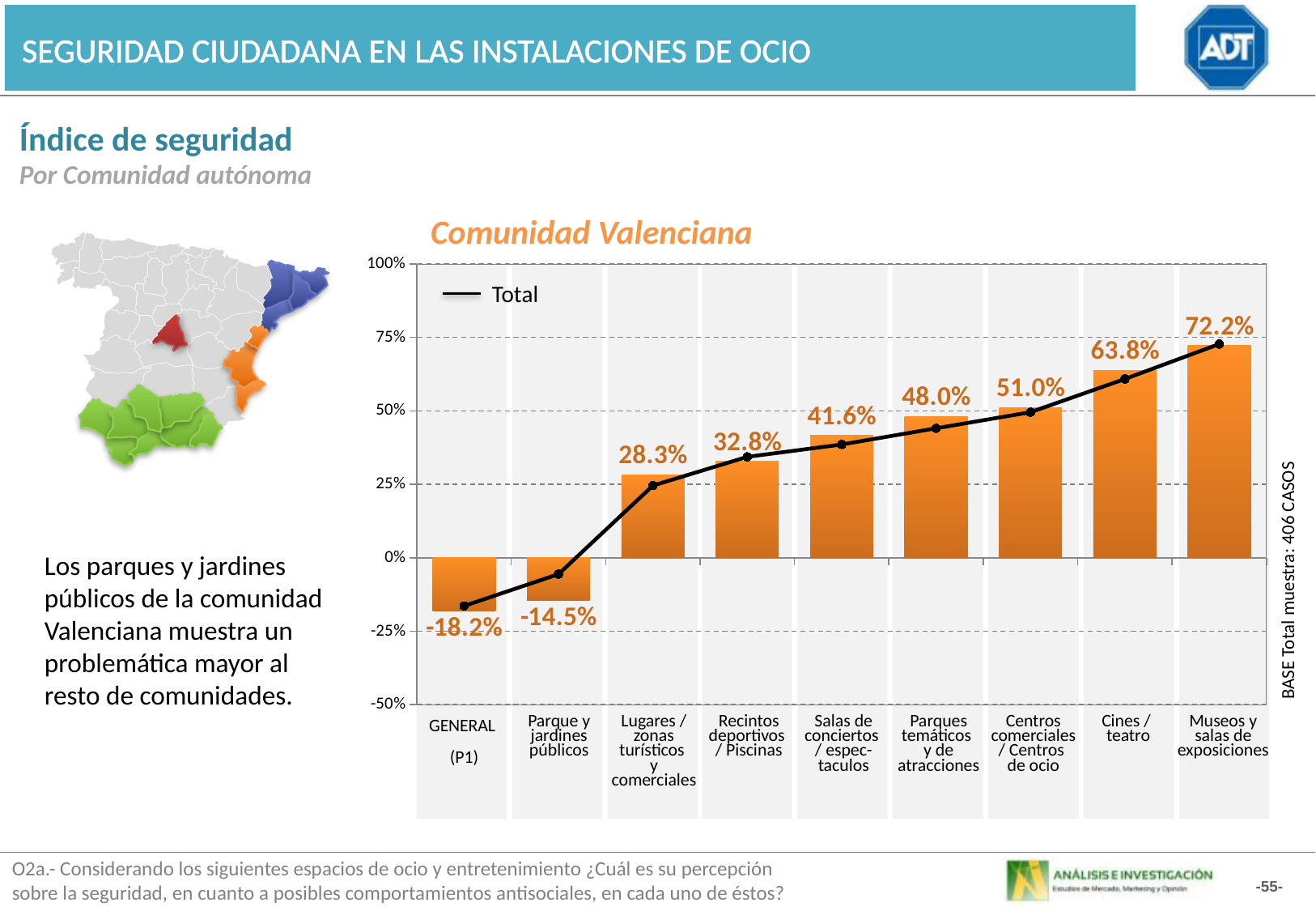
What is the value for Parque y jardines públicos? -14.5% How many series does the legend list? 1 How many categories are shown on the x axis? 9 What is the difference between the values for Cines / teatro and Centros comerciales / Centros de ocio? 12.8% What is the value for Museos y salas de exposiciones in the Comunidad Valenciana chart? 72.2% Is the Total line value for Cines / teatro greater or less than 50%? greater Which is larger, the value for Recintos deportivos / Piscinas or for Lugares / zonas turísticos y comerciales? Recintos deportivos / Piscinas Which category has the highest value? Museos y salas de exposiciones Is the Total line value for GENERAL (P1) greater or less than 0%? less Do the bar values rise or fall from left to right along the x axis? rise Which category has the lowest value? GENERAL (P1) What is the value for Salas de conciertos / espectáculos? 41.6%